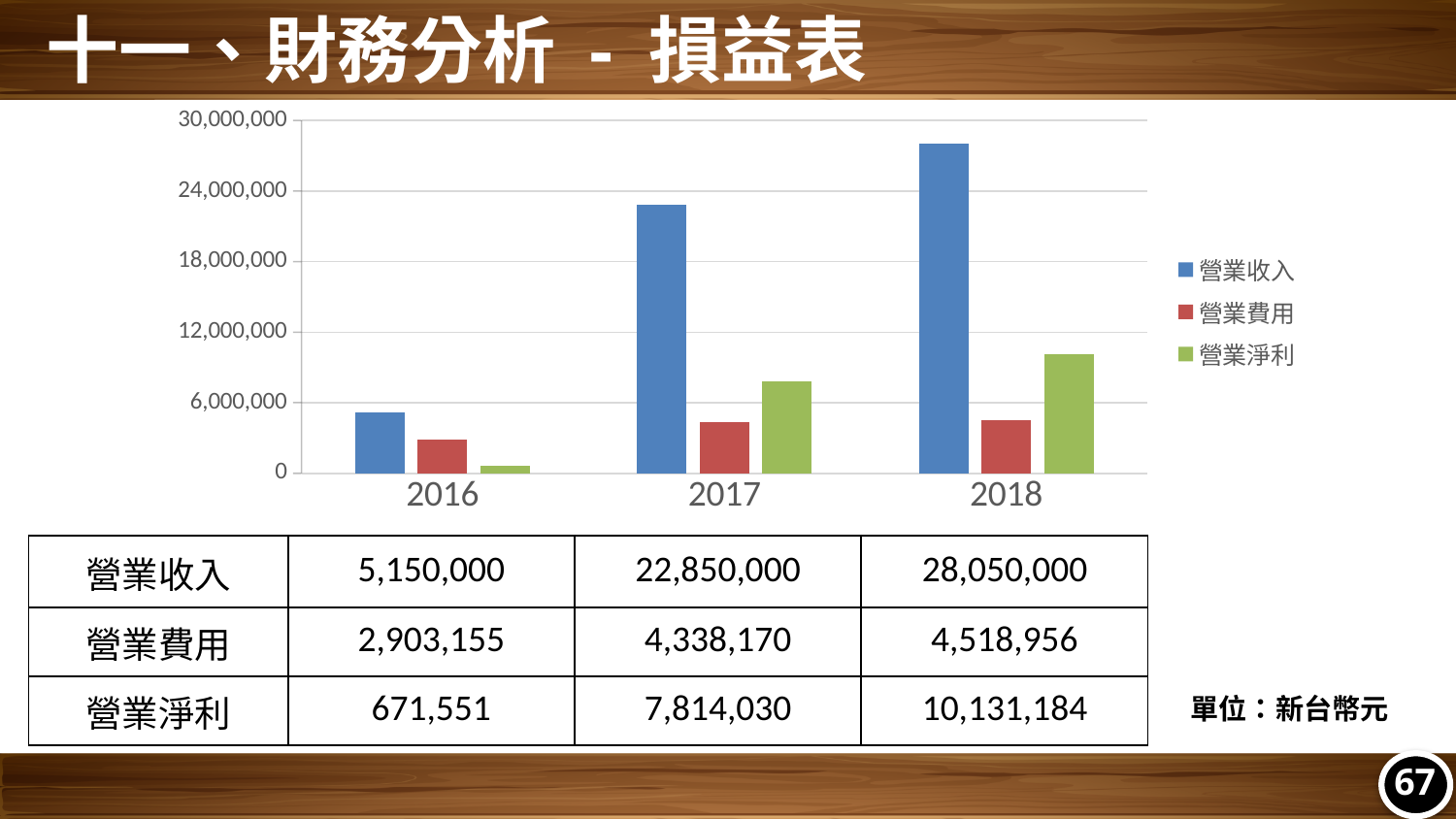
Is the value of 營業收入 for 2017 greater or less than 18,000,000? greater What is the value of 營業淨利 for 2016? 671,551 What is the difference between 營業費用 in 2018 and 2016? 1,615,801 Which year has the lowest 營業淨利? 2016 How many series does the legend list? 3 What kind of chart is shown on the slide? bar chart Does 營業收入 rise or fall from 2016 to 2018? rise What is the difference between 營業收入 in 2018 and 2017? 5,200,000 How many years are shown on the x axis of the chart? 3 Which year has the highest 營業收入? 2018 In 2017, which is larger: 營業費用 or 營業淨利? 營業淨利 What is the value of 營業收入 for 2018? 28,050,000